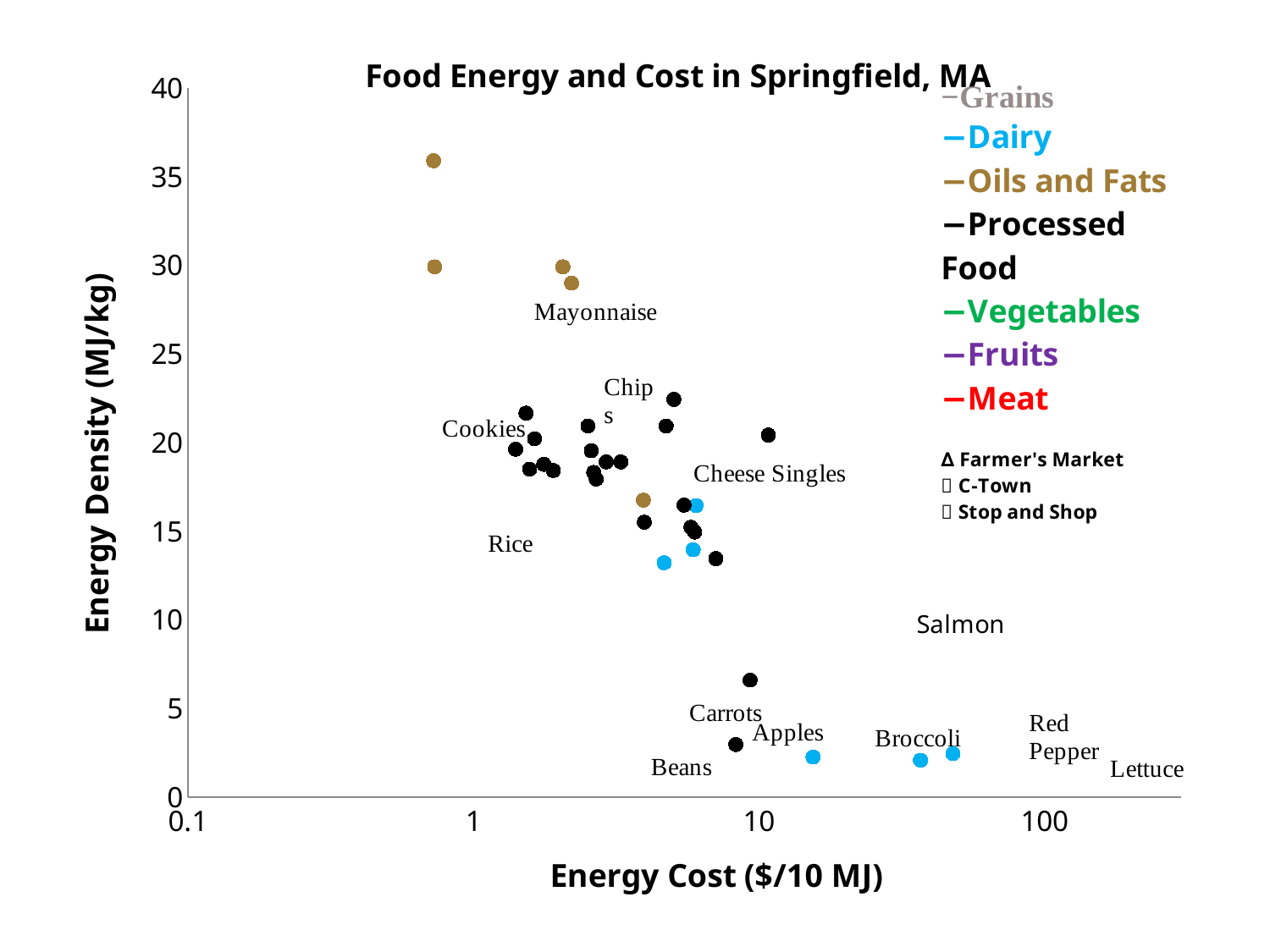
What kind of chart is shown on the slide? Scatter chart Is the energy density of the Dairy points plotted beyond 10 $/10 MJ greater or less than 5 MJ/kg? less Is the energy density of the highest point on the chart greater or less than 30 MJ/kg? greater Is the energy density of the points near the Mayonnaise label greater or less than 25 MJ/kg? greater What is the title of the chart? Food Energy and Cost in Springfield, MA Which series contains the point with the highest energy density? Oils and Fats What is the label of the x axis? Energy Cost ($/10 MJ) How many series does the legend list? 7 Which is higher in energy density: the highest Oils and Fats point or the highest Processed Food point? Oils and Fats Overall, does energy density rise or fall as energy cost increases along the x axis? fall